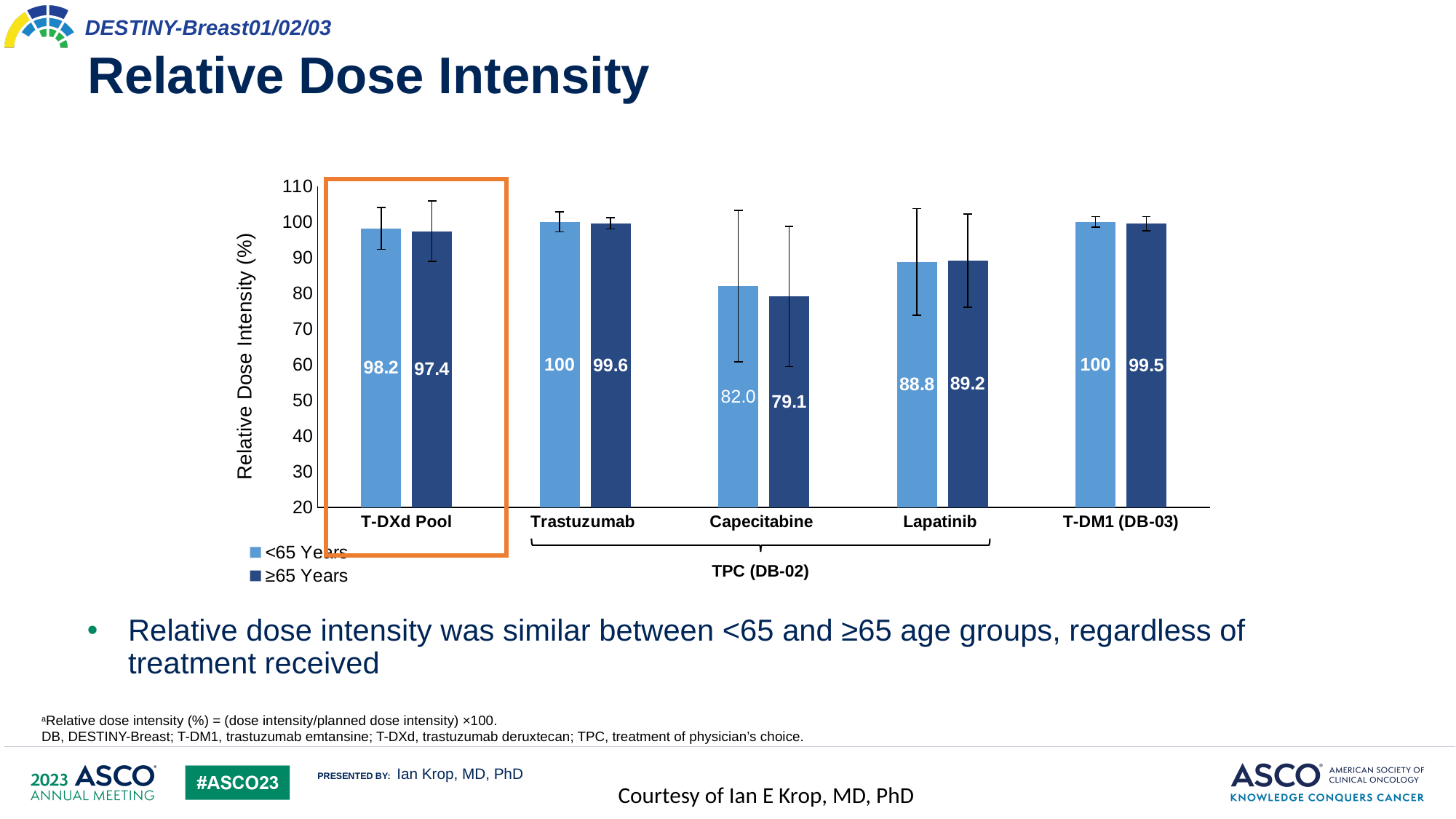
How many treatment categories are shown on the x axis? 5 Which is larger: the ≥65 Years value for Lapatinib or the ≥65 Years value for Capecitabine? Lapatinib What is the relative dose intensity for Lapatinib in the <65 Years group? 88.8 Which treatment has the lowest relative dose intensity in the <65 Years group? Capecitabine What is the relative dose intensity for Capecitabine in the ≥65 Years group? 79.1 What kind of chart is shown on the slide? Bar chart What is the relative dose intensity for T-DM1 (DB-03) in the ≥65 Years group? 99.5 What is the relative dose intensity for T-DXd Pool in the <65 Years group? 98.2 What is the difference between the <65 Years and ≥65 Years values for Capecitabine? 2.9 How many series does the legend list? 2 Which treatment has the lowest relative dose intensity in the ≥65 Years group? Capecitabine What is the difference between the <65 Years values for Trastuzumab and Lapatinib? 11.2